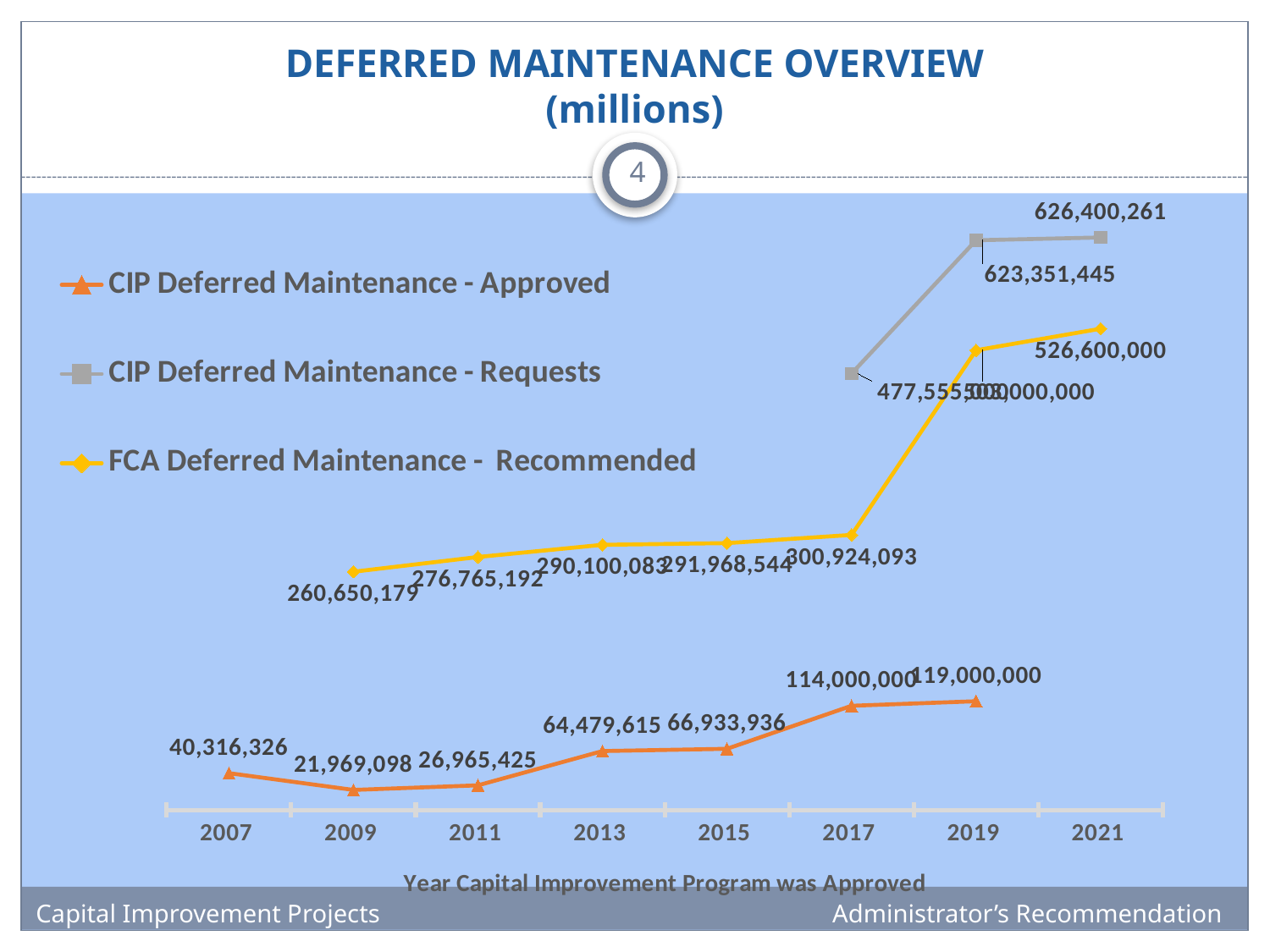
What kind of chart is shown on the slide? Line chart What is the value of CIP Deferred Maintenance - Approved in 2019? 119,000,000 What is the difference between CIP Deferred Maintenance - Approved in 2019 and in 2017? 5,000,000 In which year is CIP Deferred Maintenance - Requests at its highest? 2021 Which is larger in 2015: FCA Deferred Maintenance - Recommended or CIP Deferred Maintenance - Approved? FCA Deferred Maintenance - Recommended In which year is CIP Deferred Maintenance - Approved at its lowest? 2009 How many years are shown on the x axis? 8 What is the title of the x axis? Year Capital Improvement Program was Approved How many series does the legend list? 3 What is the value of FCA Deferred Maintenance - Recommended in 2009? 260,650,179 What is the value of CIP Deferred Maintenance - Requests in 2021? 626,400,261 What is the value of CIP Deferred Maintenance - Approved in 2007? 40,316,326